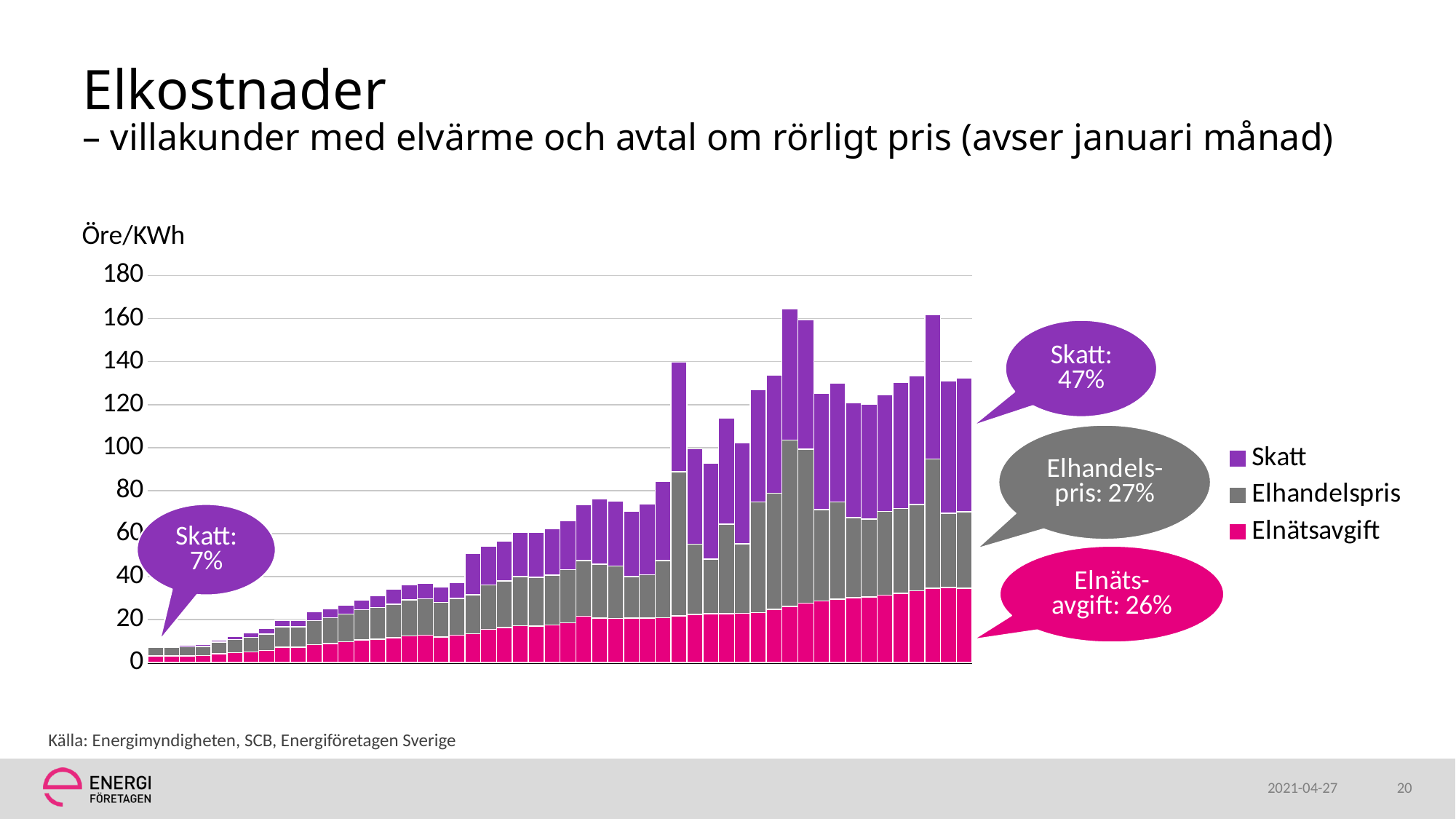
According to the callout, what share of the most recent bar is Elhandelspris? 27% What kind of chart is shown on the slide? Stacked bar chart How many series does the legend list? 3 Is the total of the last (rightmost) bar greater or less than 120? greater Do the total bar heights generally rise or fall from left to right along the x axis? Rise Is the total of the first (leftmost) bar greater or less than 20? less According to the callout pointing at the first bar, what share of that bar is Skatt? 7% Which series does the legend list first? Skatt Is the total of the tallest bar greater or less than 140? greater According to the callout, what share of the most recent bar is Elnätsavgift? 26% What unit is shown on the y axis of the chart? Öre/KWh